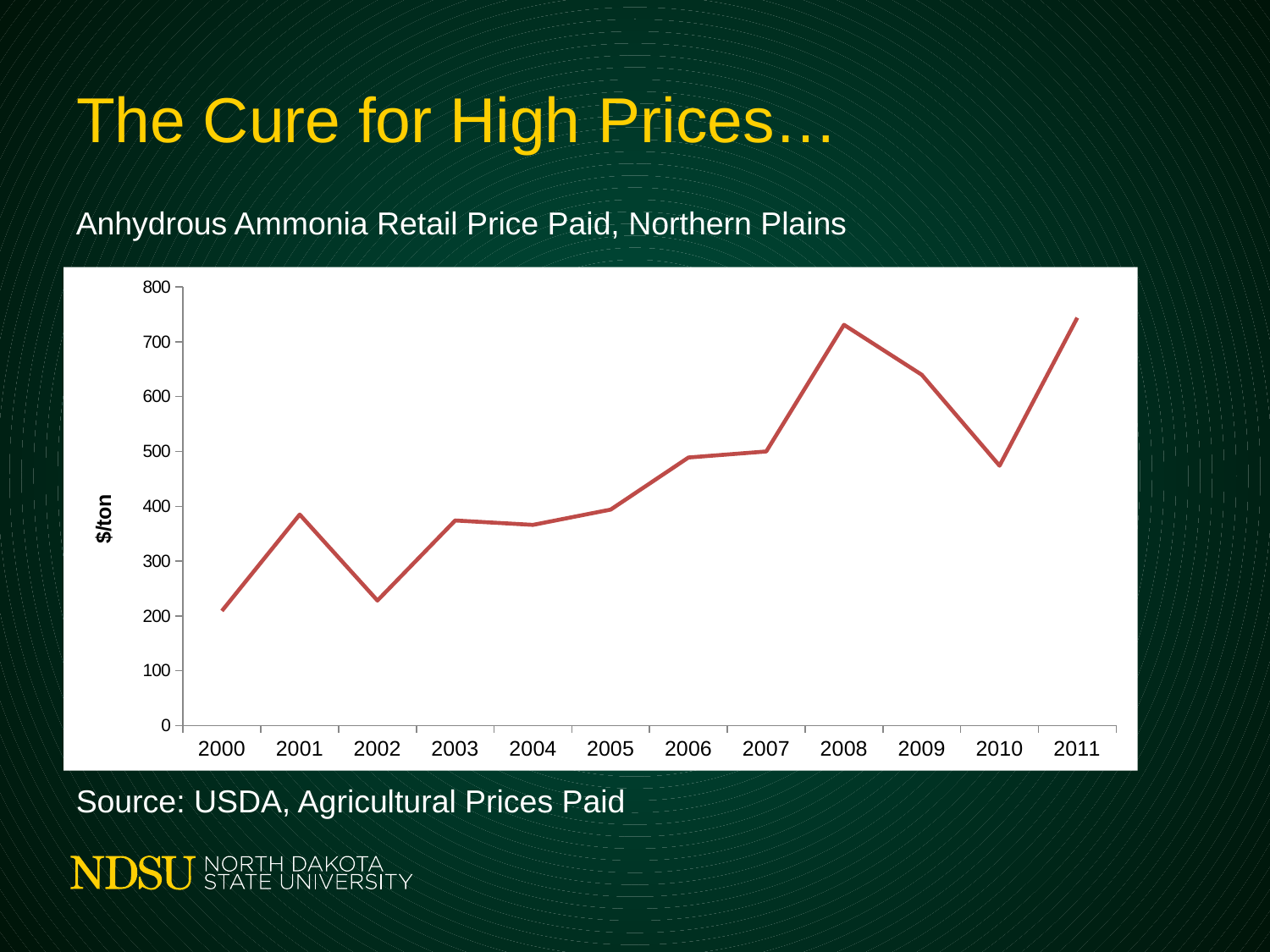
Is the value for 2008 greater or less than 700? greater Which year has the larger value, 2008 or 2010? 2008 What kind of chart is shown on the slide? line chart What is the label on the vertical axis of the chart? $/ton How many years are plotted on the x axis of the chart? 12 Is the value for 2010 greater or less than 500? less Is the value for 2000 greater or less than 300? less Which year has the larger value, 2001 or 2002? 2001 What is the title of the chart? Anhydrous Ammonia Retail Price Paid, Northern Plains Overall, does the price rise or fall from 2000 to 2011? rise